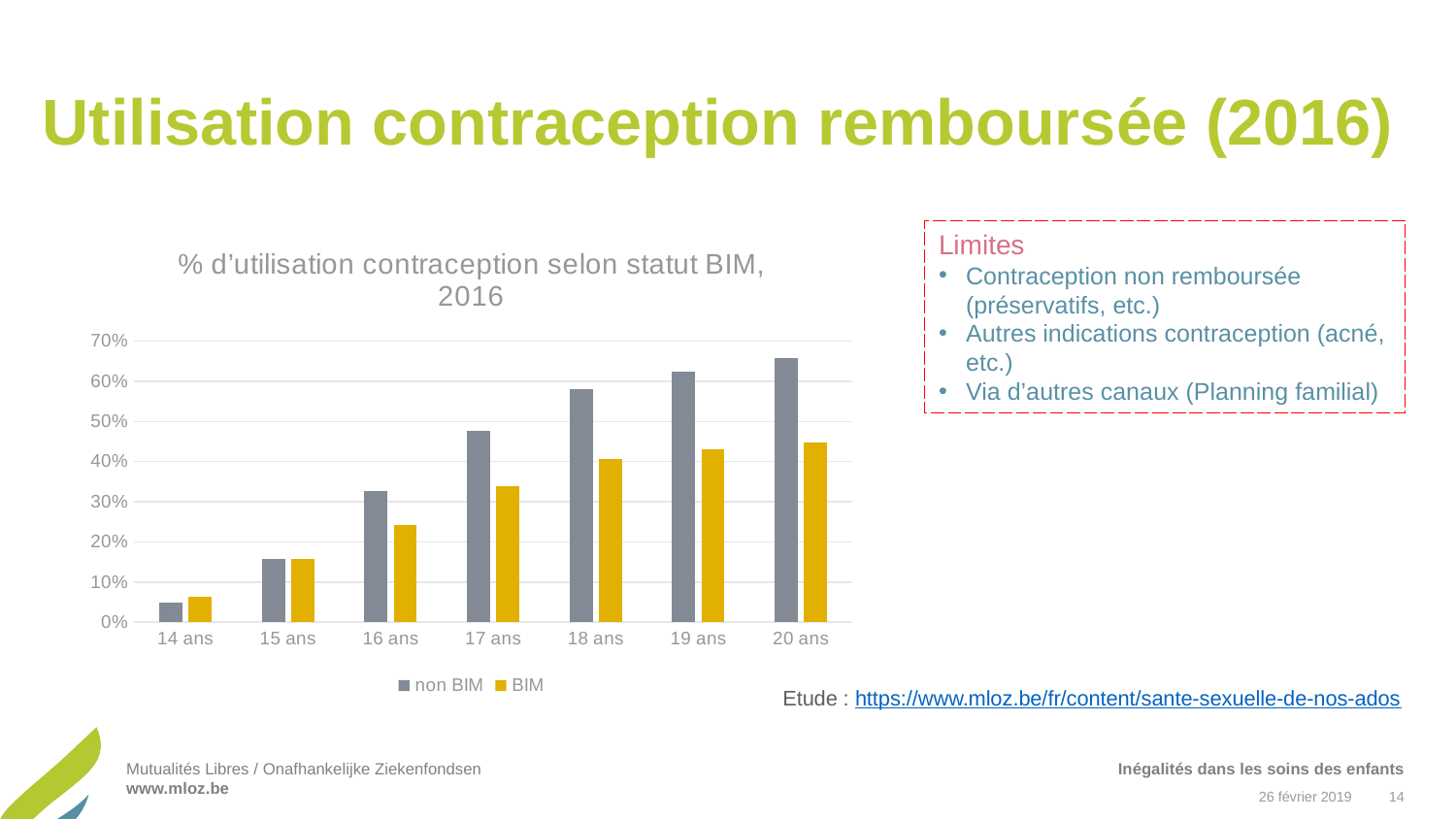
Do the non BIM values rise or fall as age increases from 14 ans to 20 ans? rise Is the BIM value for 20 ans greater or less than 50%? less Is the BIM value for 16 ans greater or less than 30%? less Which age category has the highest value for the BIM series? 20 ans What kind of chart is shown on the slide? bar chart How many age categories are shown on the x axis? 7 What is the title of the chart? % d'utilisation contraception selon statut BIM, 2016 How many series does the legend list? 2 At 17 ans, which series has the larger value, non BIM or BIM? non BIM Is the non BIM value for 18 ans greater or less than 50%? greater Which age category has the highest value for the non BIM series? 20 ans Which age category has the lowest value for the non BIM series? 14 ans